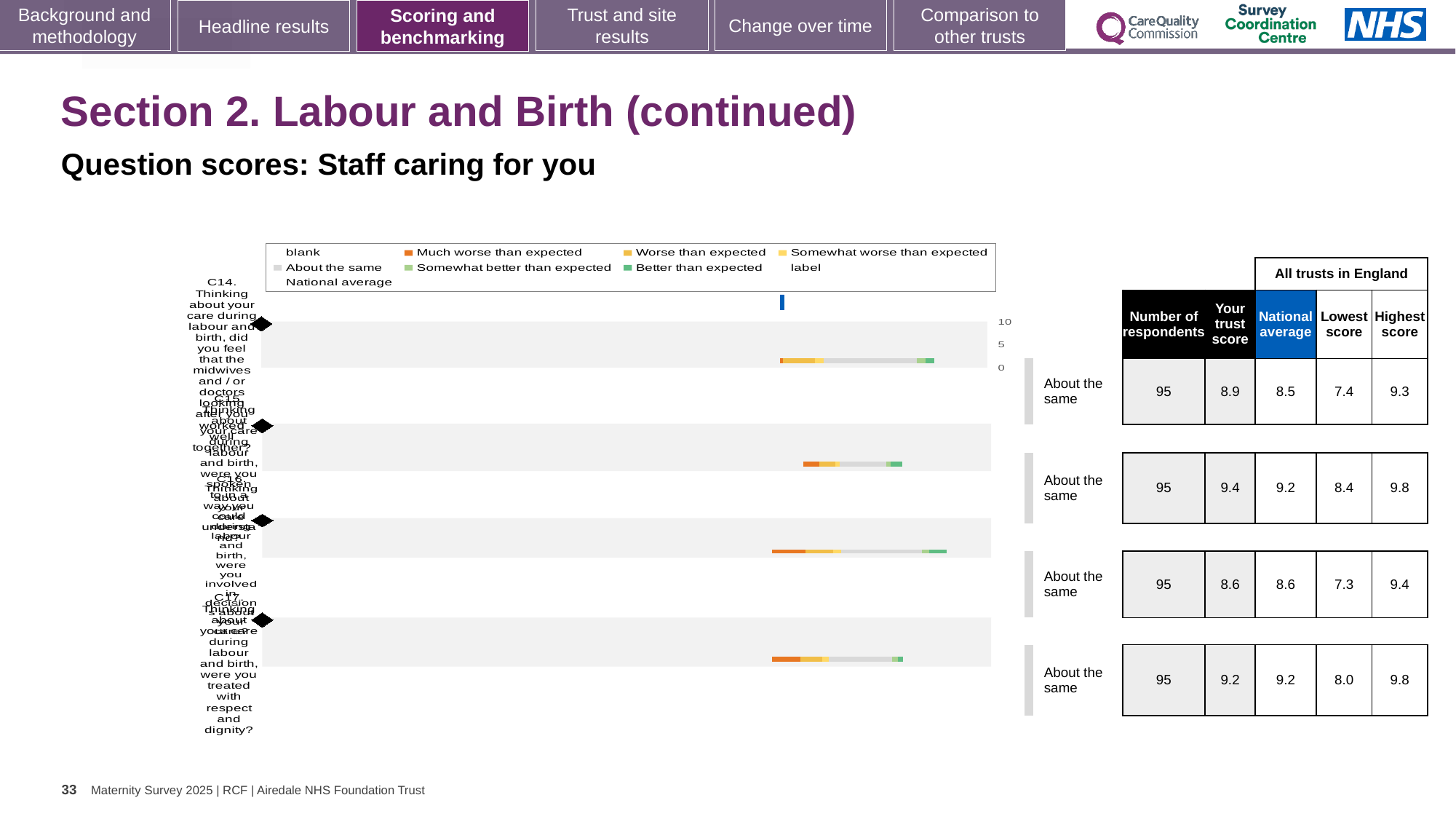
What kind of chart is shown on the slide? bar chart For the first row (C14), which is larger: the trust score or the national average? the trust score What is the highest score among all trusts in England for the fourth row (C17)? 9.8 What is the 'Your trust score' for the first row (C14) of the chart? 8.9 Which row has the highest 'Your trust score'? C15 What is the difference between the trust score and the national average for the first row (C14)? 0.4 What benchmark category is shown for every row of the chart? About the same What is the national average for the second row (C15) of the chart? 9.2 What is the lowest score among all trusts in England for the third row (C16)? 7.3 How many entries does the chart legend list? 9 How many respondents are shown for the first row (C14)? 95 How many question rows (categories) does the chart show? 4